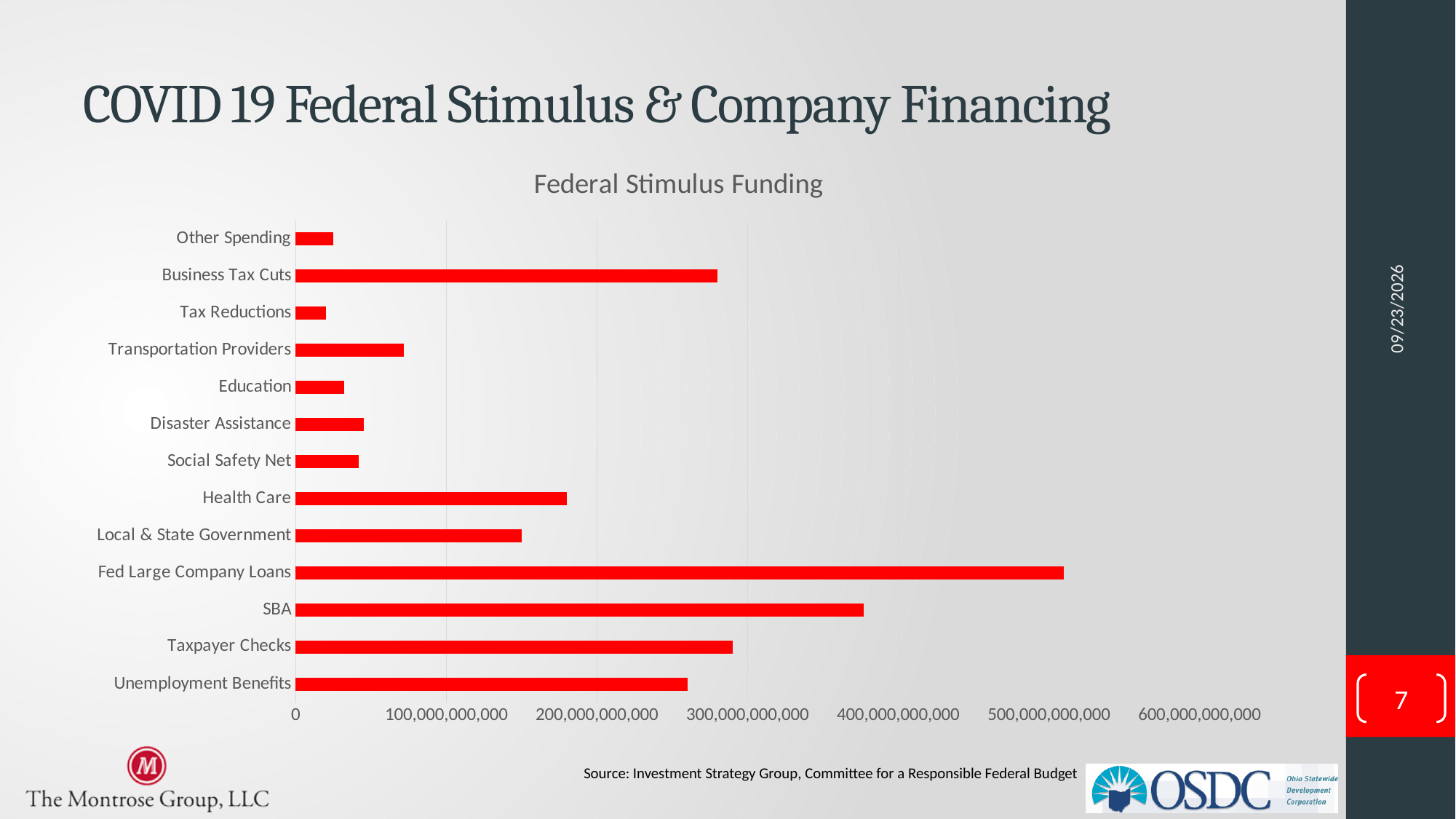
Is the value for Health Care greater or less than 200,000,000,000? less What is the title of the chart? Federal Stimulus Funding Which category has the highest value in the chart? Fed Large Company Loans Which is larger, the value for SBA or the value for Taxpayer Checks? SBA What kind of chart is shown on the slide? bar chart Is the value for Fed Large Company Loans greater or less than 400,000,000,000? greater Is the value for Local & State Government greater or less than 100,000,000,000? greater Which is larger, the value for Health Care or the value for Local & State Government? Health Care How many categories are plotted in the chart? 13 What colour are the bars in the chart? red